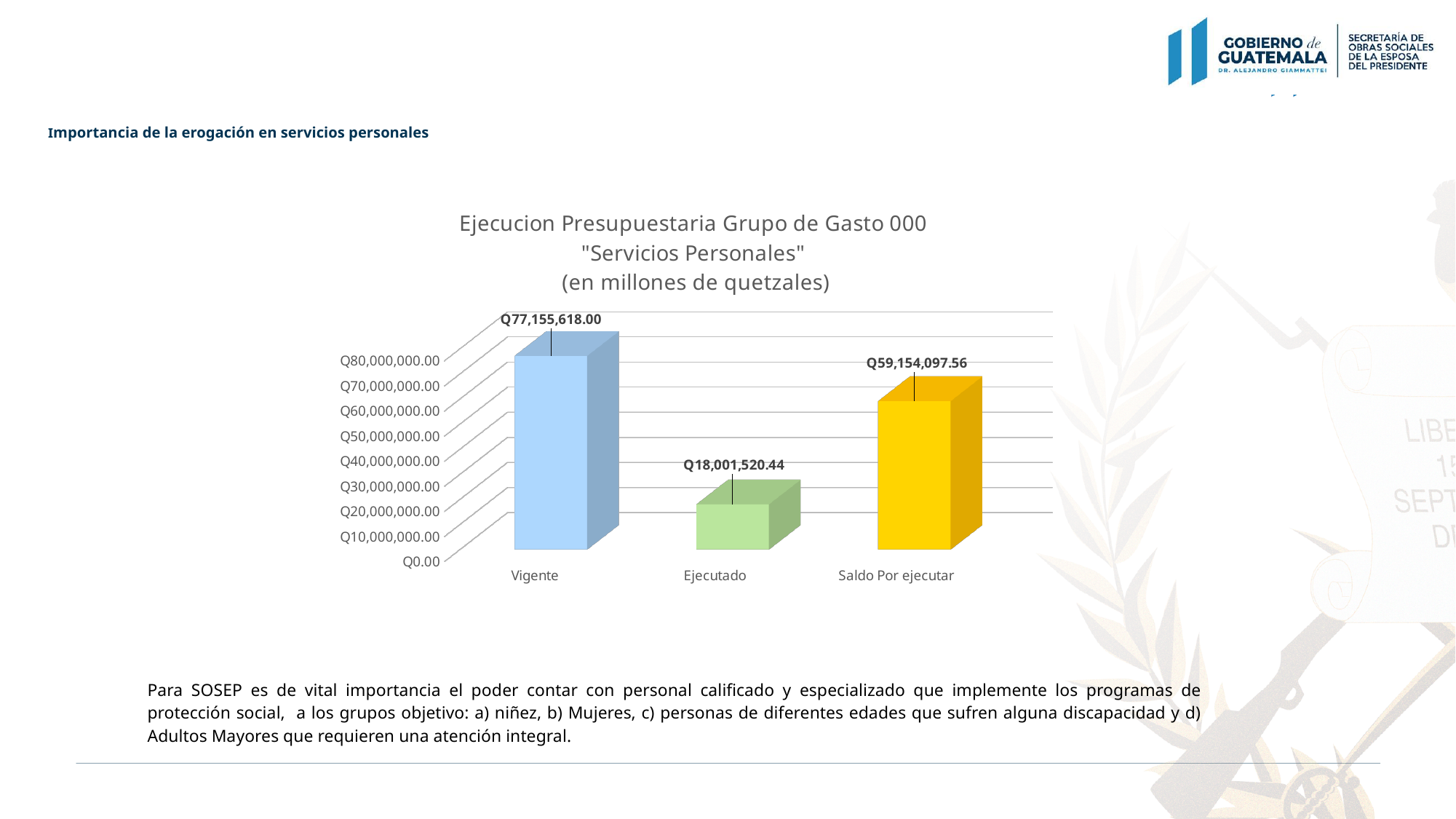
What is the value for Ejecutado? Q18,001,520.44 What kind of chart is shown on the slide? bar chart What is the difference between the Saldo Por ejecutar and Ejecutado values? Q41,152,577.12 Which category has the highest value? Vigente What is the title of the chart? Ejecucion Presupuestaria Grupo de Gasto 000 "Servicios Personales" (en millones de quetzales) How many categories are shown on the x axis? 3 Which category has the lowest value? Ejecutado What is the value for Vigente? Q77,155,618.00 What is the value for Saldo Por ejecutar? Q59,154,097.56 Which is larger, the value for Ejecutado or the value for Saldo Por ejecutar? Saldo Por ejecutar What is the difference between the Vigente and Ejecutado values? Q59,154,097.56 Is the value for Ejecutado greater or less than Q20,000,000.00? less